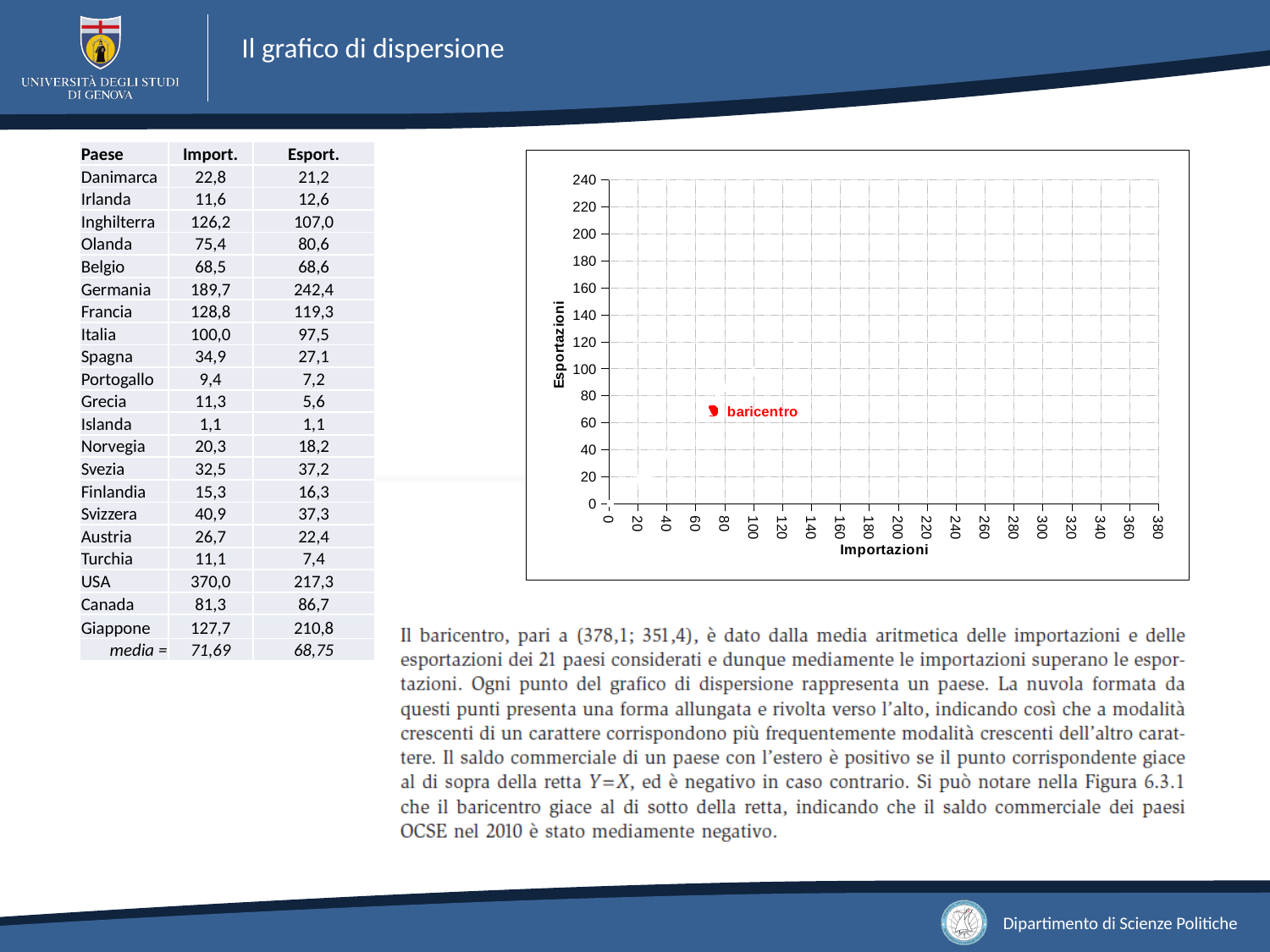
What is the highest tick value shown on the vertical axis of the scatter chart? 240 How many data points are plotted on the scatter chart? 1 What is the highest tick value shown on the horizontal axis of the scatter chart? 380 What is the label of the point plotted on the scatter chart? baricentro Is the Esportazioni value of the baricentro point greater or less than 60? greater What is the title of the horizontal axis of the scatter chart? Importazioni Is the Importazioni value of the baricentro point greater or less than 100? less What is the title of the vertical axis of the scatter chart? Esportazioni Is the Importazioni value of the baricentro point greater or less than 60? greater What kind of chart is shown on the slide? scatter chart